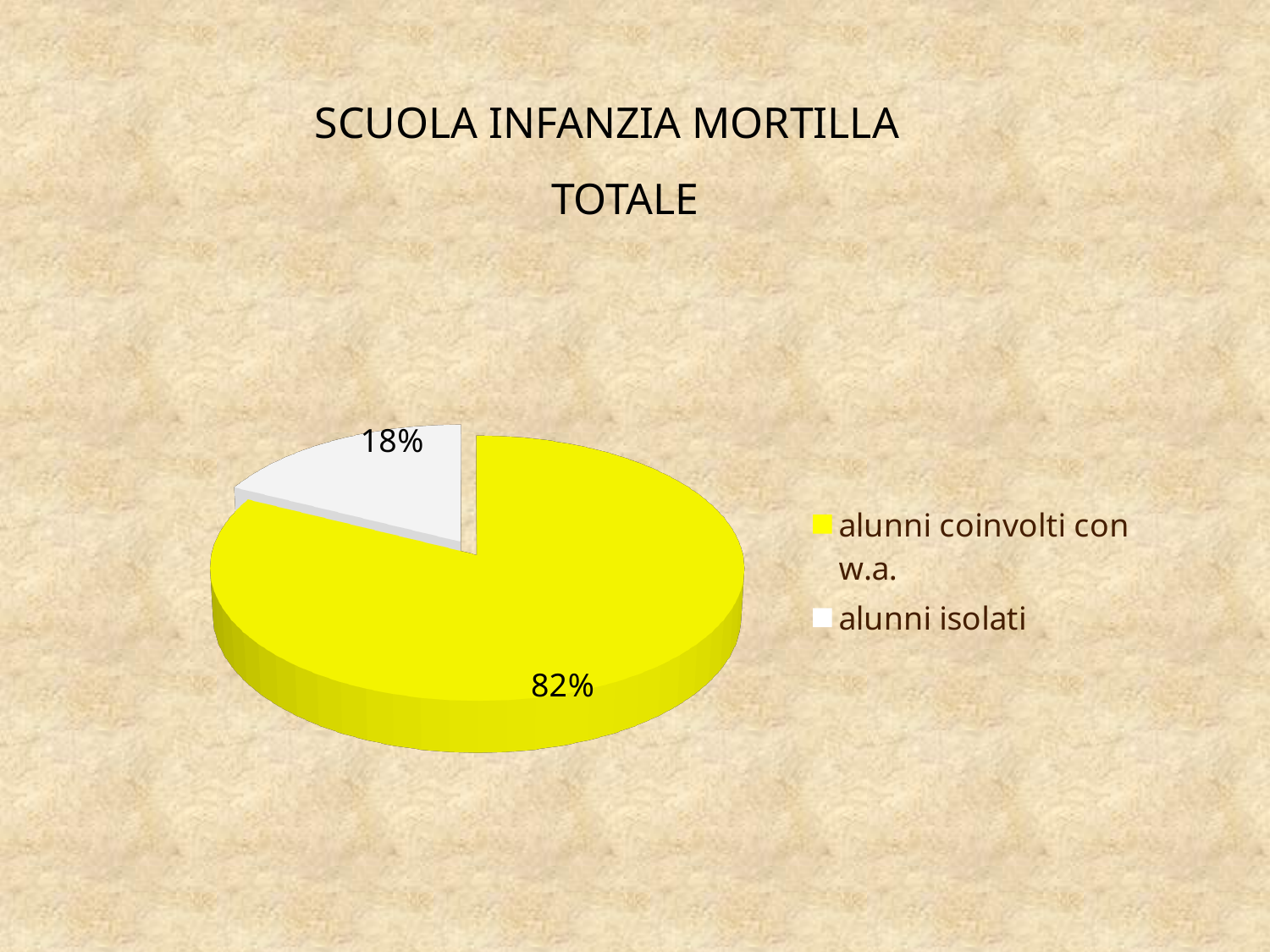
What share of the pie is labelled "alunni isolati"? 18% What is the difference in percentage points between the "alunni coinvolti con w.a." slice and the "alunni isolati" slice? 64 Which is larger: the share for "alunni coinvolti con w.a." or the share for "alunni isolati"? alunni coinvolti con w.a. What colour is the slice for "alunni coinvolti con w.a."? yellow What type of chart is shown on the slide? pie chart What is the title of the chart? SCUOLA INFANZIA MORTILLA TOTALE How many entries does the legend list? 2 Which category has the smallest slice of the pie? alunni isolati What share of the pie is labelled "alunni coinvolti con w.a."? 82% Which category has the largest slice of the pie? alunni coinvolti con w.a. How many slices does the pie chart have? 2